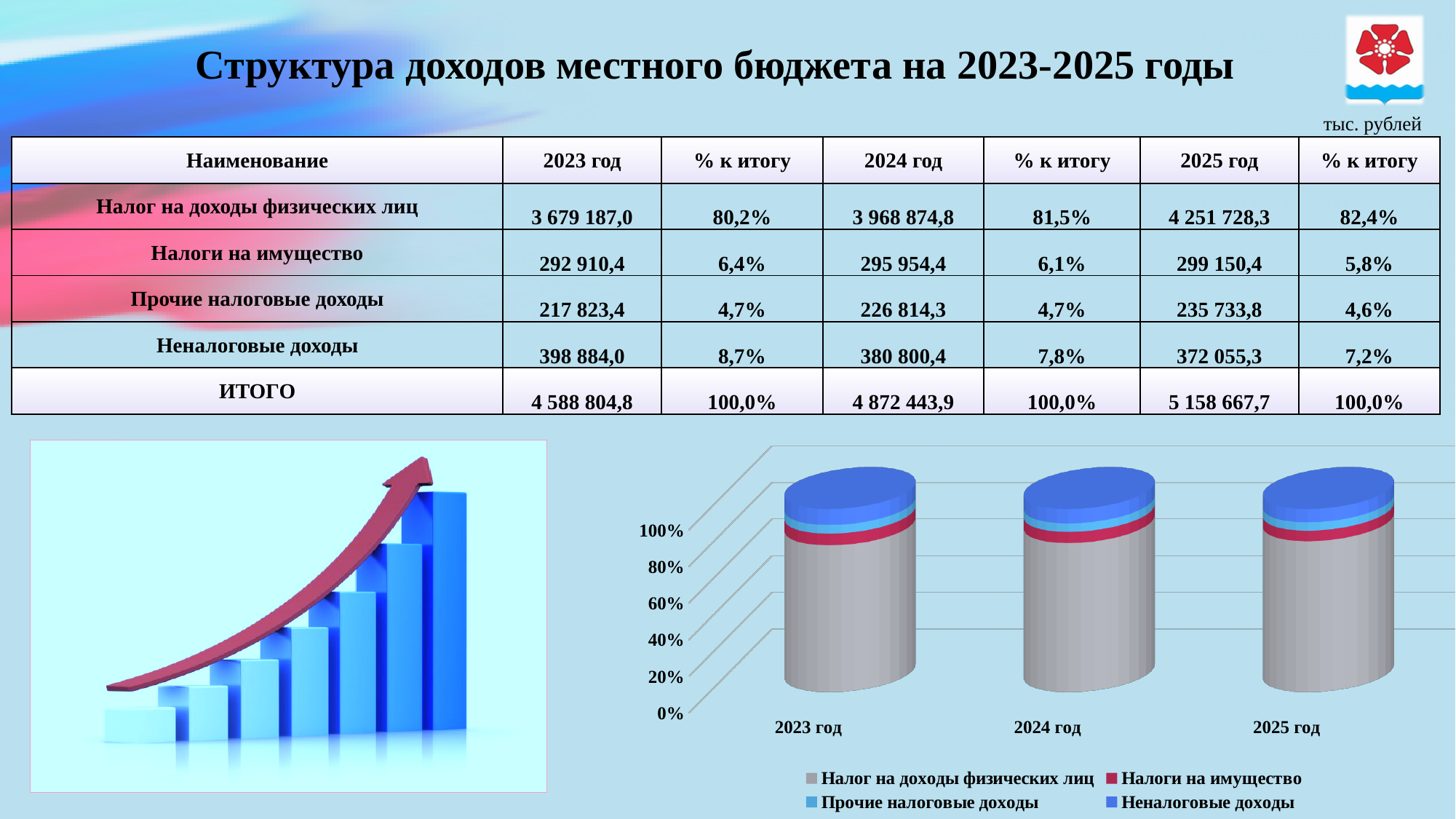
What kind of chart is shown at the bottom right of the slide? bar chart Which years are shown as categories on the chart's x axis? 2023 год, 2024 год, 2025 год What is the highest tick label shown on the chart's vertical axis? 100% How many series does the chart's legend list? 4 In the chart, which is larger for 2024 год: 'Налог на доходы физических лиц' or 'Неналоговые доходы'? Налог на доходы физических лиц What does each stacked bar in the chart total? 100% In the chart, is the share of 'Налог на доходы физических лиц' for 2023 год greater or less than 60%? greater Which series takes up the largest part of the 2023 год bar in the chart? Налог на доходы физических лиц Which colour represents 'Налог на доходы физических лиц' in the chart? grey How many categories (years) are shown on the x axis of the chart? 3 In the chart, is the share of 'Налоги на имущество' for 2025 год greater or less than 20%? less